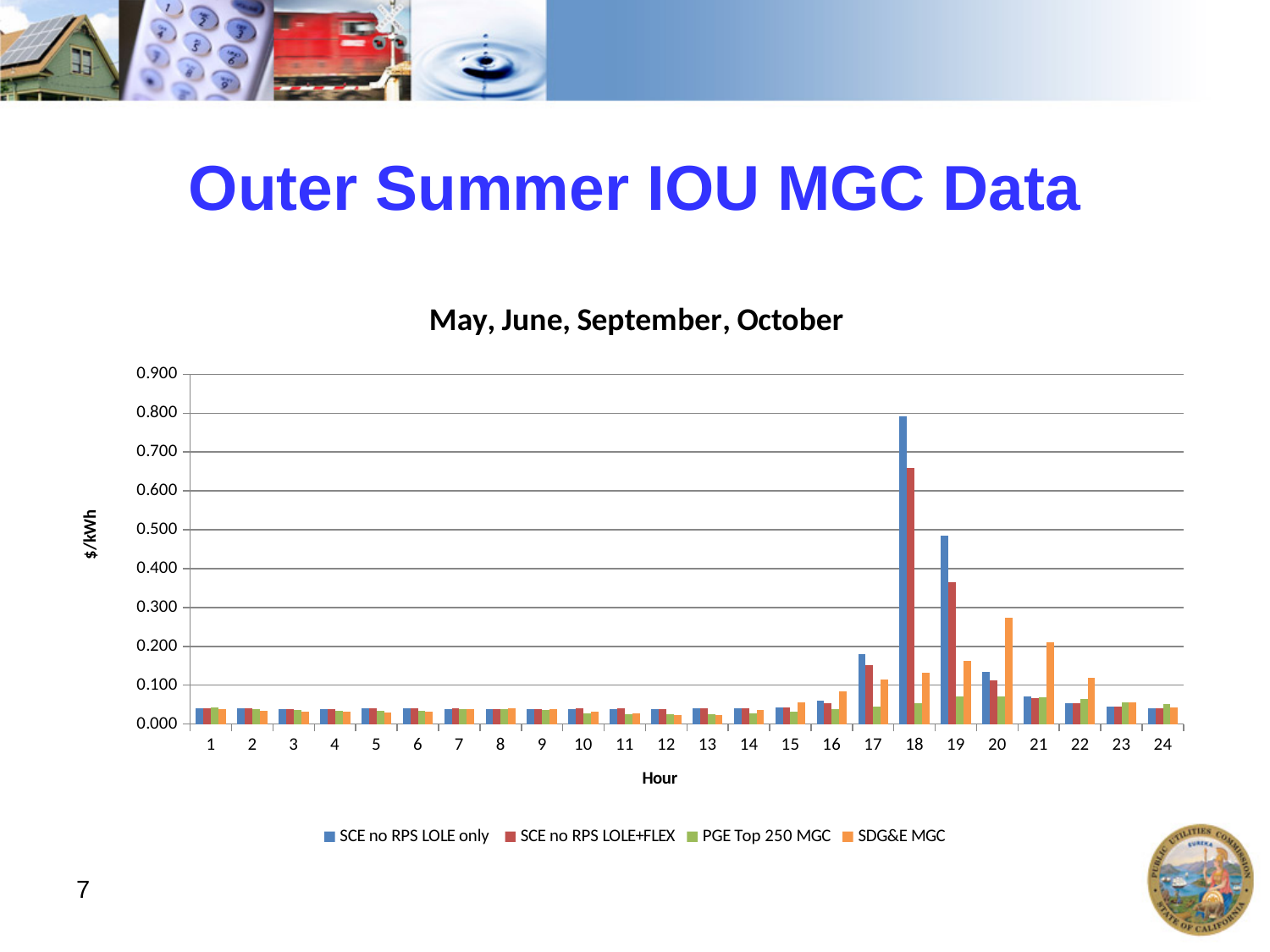
At hour 20, which is larger: SDG&E MGC or SCE no RPS LOLE only? SDG&E MGC At which hour does the SDG&E MGC series reach its highest value? 20 How many hours are shown along the x axis? 24 Is the value for SCE no RPS LOLE only at hour 19 greater or less than 0.400? greater What is the label of the y axis? $/kWh What kind of chart is shown on the slide? bar chart Is the value for SCE no RPS LOLE+FLEX at hour 18 greater or less than 0.600? greater Is the value for SCE no RPS LOLE only at hour 18 greater or less than 0.700? greater At which hour does the SCE no RPS LOLE only series reach its highest value? 18 At hour 18, which is larger: SCE no RPS LOLE only or SCE no RPS LOLE+FLEX? SCE no RPS LOLE only How many series does the legend list? 4 What is the title of the chart? May, June, September, October